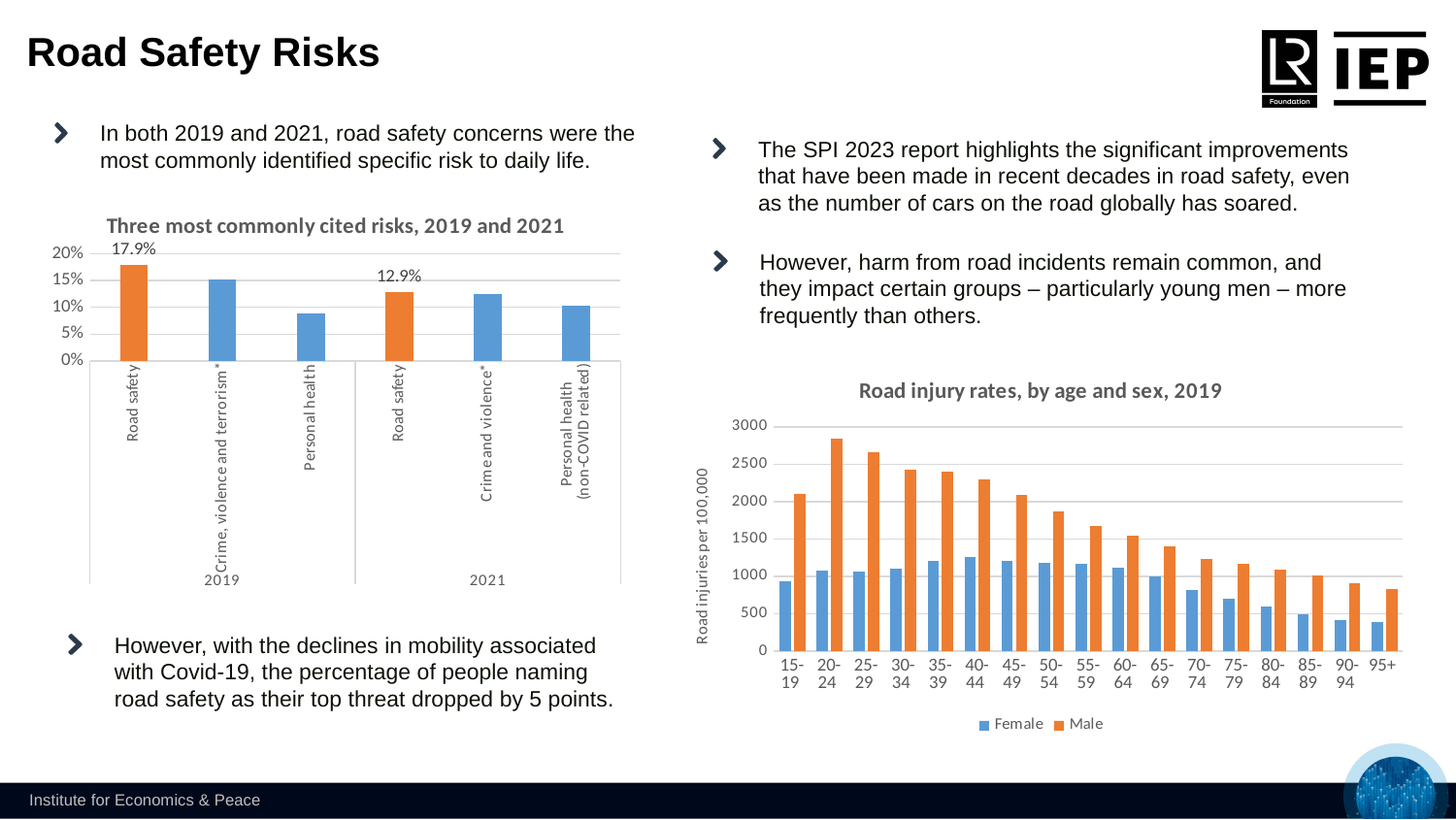
On the 'Road injury rates, by age and sex, 2019' chart, which age group has the highest Male road injury rate? 20-24 What kind of chart is 'Road injury rates, by age and sex, 2019'? Bar chart On the 'Road injury rates, by age and sex, 2019' chart, is the Male value for the 20-24 age group greater or less than 2500? greater On the 'Road injury rates, by age and sex, 2019' chart, which age group has the lowest Female road injury rate? 95+ How many series does the legend of the 'Road injury rates, by age and sex, 2019' chart list? 2 On the 'Three most commonly cited risks, 2019 and 2021' chart, what percentage cited road safety in 2019? 17.9% On the 'Three most commonly cited risks, 2019 and 2021' chart, by how many percentage points did the road safety value fall from 2019 to 2021? 5.0% On the 'Road injury rates, by age and sex, 2019' chart, do the Male values rise or fall across the age groups from 20-24 to 95+? Fall On the 'Three most commonly cited risks, 2019 and 2021' chart, how many bars are plotted in total? 6 On the 'Three most commonly cited risks, 2019 and 2021' chart, what percentage cited road safety in 2021? 12.9% On the 'Three most commonly cited risks, 2019 and 2021' chart, which is larger: Road safety in 2019 or Crime, violence and terrorism in 2019? Road safety in 2019 On the 'Three most commonly cited risks, 2019 and 2021' chart, is the value for Personal health in 2019 greater or less than 10%? less